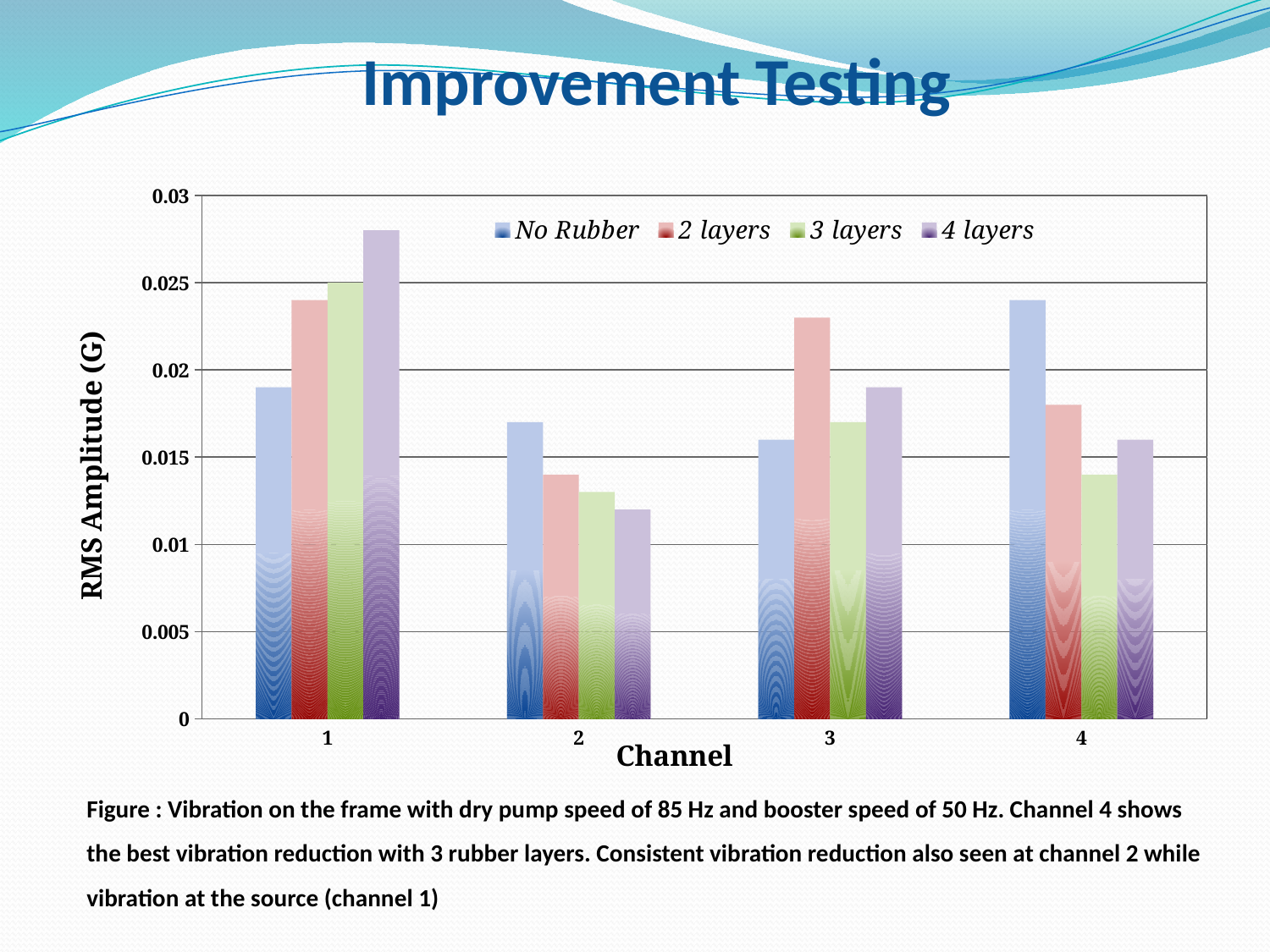
For the No Rubber series, which is larger: the value at channel 1 or at channel 4? channel 4 Is the value for 3 layers at channel 4 greater or less than 0.015? less Is the value for No Rubber at channel 2 greater or less than 0.015? greater At channel 3, which series has the highest RMS amplitude? 2 layers Is the value for 4 layers at channel 1 greater or less than 0.025? greater At channel 1, which series has the highest RMS amplitude? 4 layers What kind of chart is shown on the slide? bar chart What is the label of the vertical axis? RMS Amplitude (G) How many series does the legend list? 4 At channel 4, which series has the lowest RMS amplitude? 3 layers At channel 2, which series has the lowest RMS amplitude? 4 layers How many channels are shown on the x axis? 4